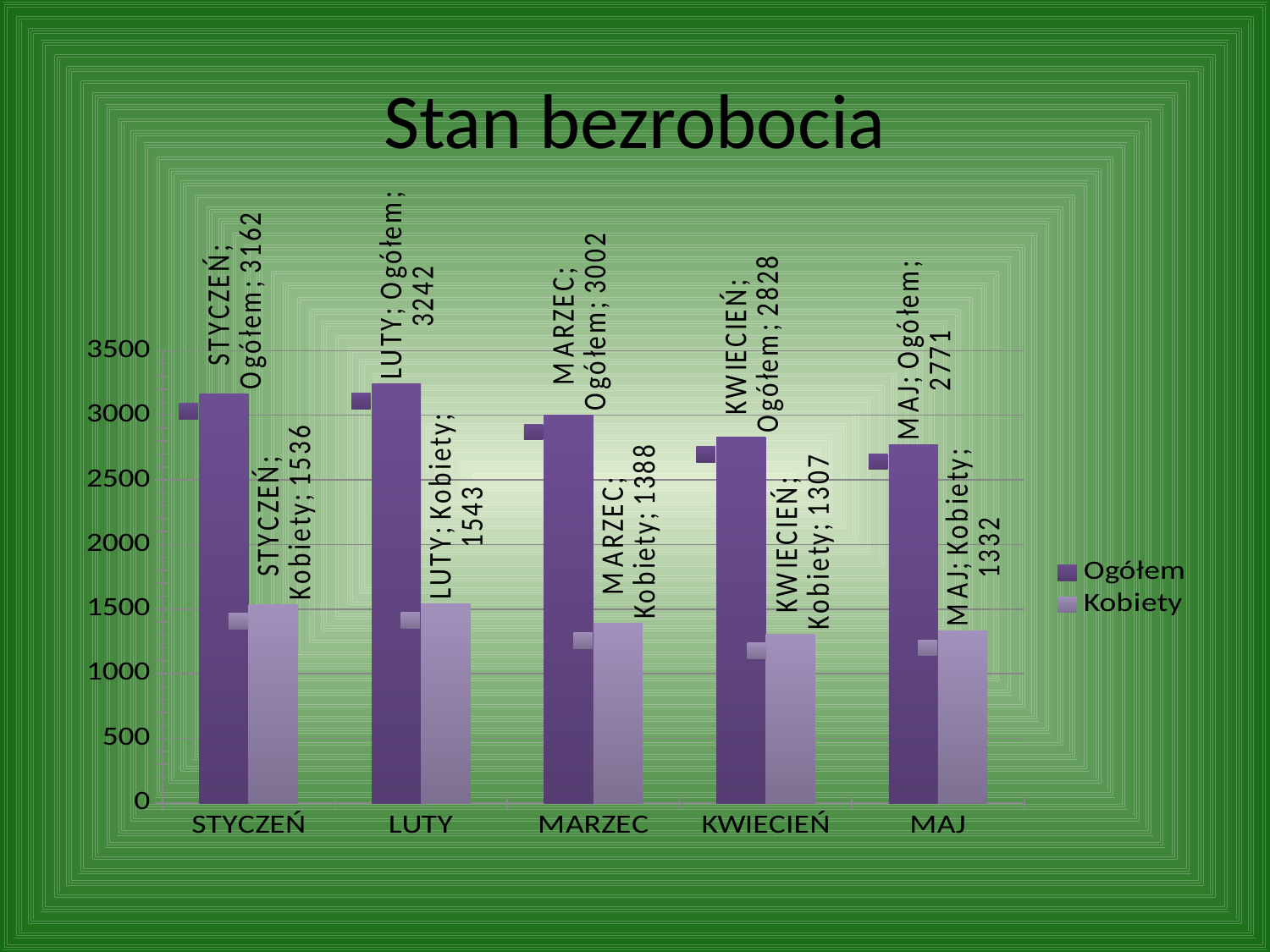
What is the Ogółem value for MAJ? 2771 How many series does the legend list? 2 What is the difference between the Ogółem values for STYCZEŃ and MAJ? 391 What is the Kobiety value for MARZEC? 1388 What is the Ogółem value for LUTY? 3242 How many months are shown on the x axis? 5 Which month has the lowest Kobiety value? KWIECIEŃ What kind of chart is shown on the slide? bar chart Which is larger, the Kobiety value for STYCZEŃ or for MAJ? STYCZEŃ Which month has the highest Ogółem value? LUTY Does the Ogółem value rise or fall from LUTY to MAJ? fall What is the title of the chart? Stan bezrobocia